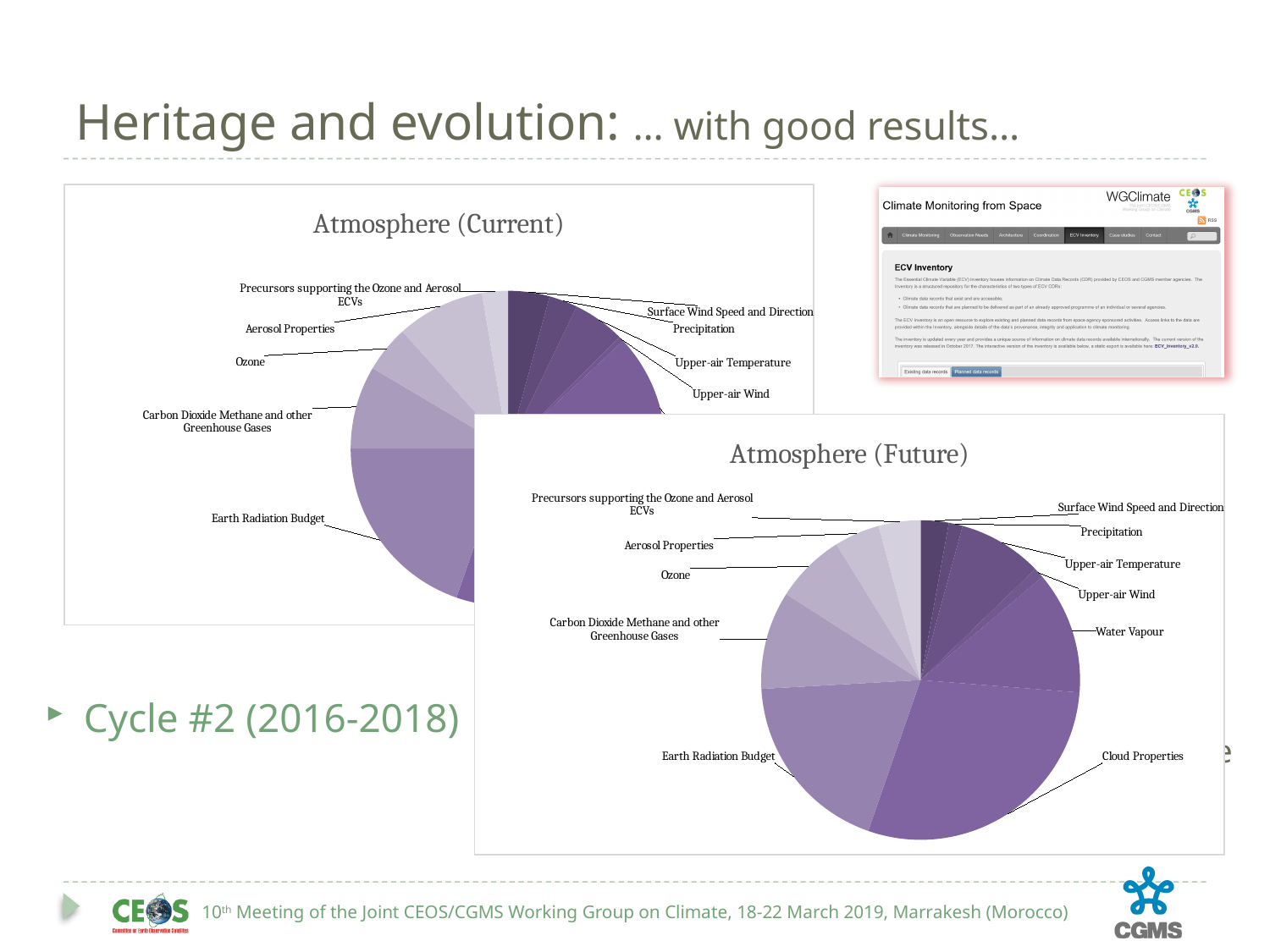
In the "Atmosphere (Current)" chart, which slice is larger: Earth Radiation Budget or Ozone? Earth Radiation Budget In the "Atmosphere (Future)" chart, which slice is larger: Ozone or Cloud Properties? Cloud Properties In the "Atmosphere (Future)" chart, how many categories (slices) are labelled? 11 What is the title of the pie chart in the lower right of the slide? Atmosphere (Future) In the "Atmosphere (Future)" chart, which slice is larger: Earth Radiation Budget or Water Vapour? Earth Radiation Budget In the "Atmosphere (Future)" chart, which category has the largest slice? Cloud Properties What is the title of the pie chart in the upper left of the slide? Atmosphere (Current) What kind of chart is the "Atmosphere (Future)" chart? Pie chart What kind of chart is the "Atmosphere (Current)" chart? Pie chart